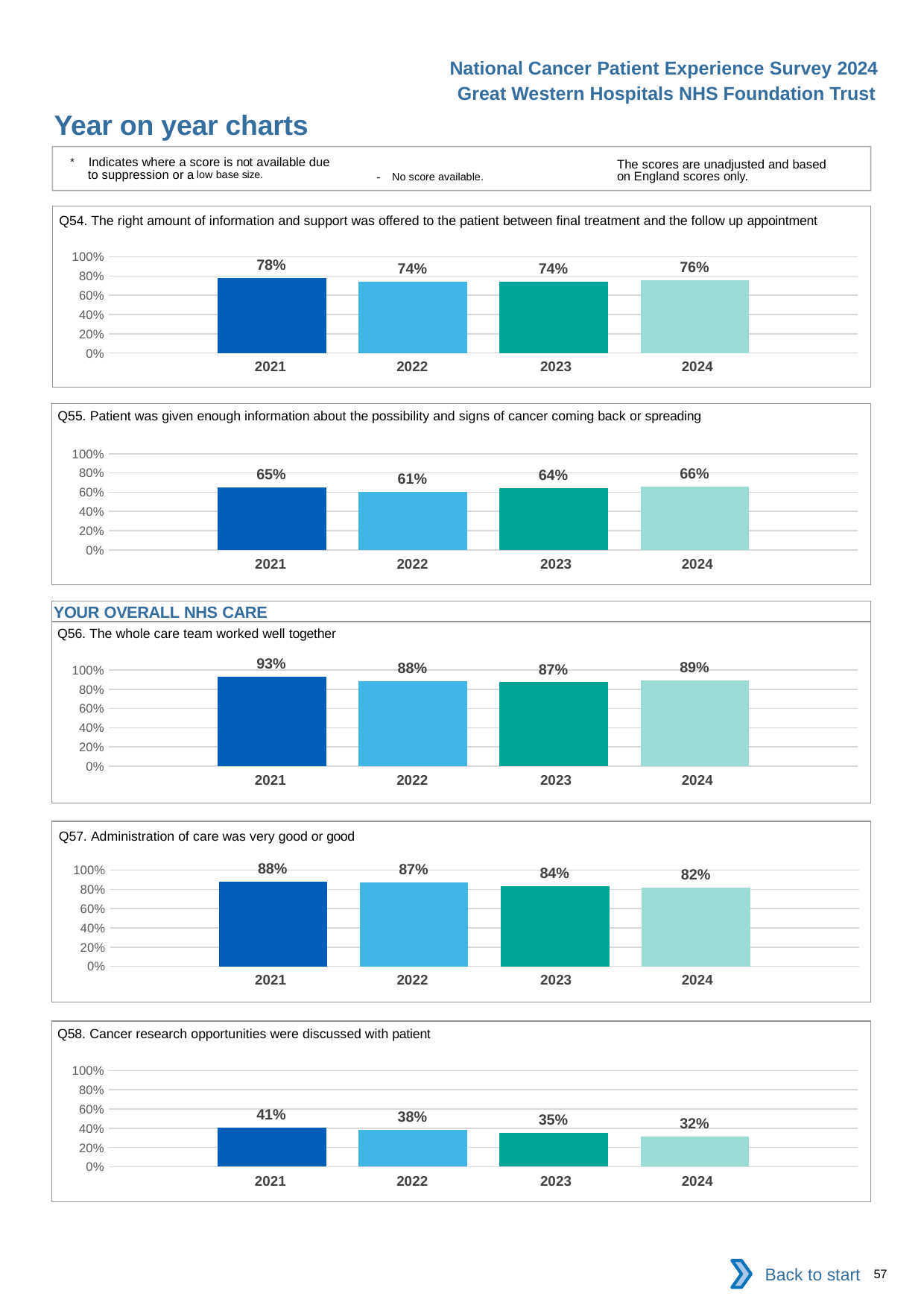
In the Q58 chart, is the value for 2021 greater or less than 60%? less In the Q54 chart, what is the value for 2021? 78% How many years are shown in the Q54 chart? 4 In the Q55 chart, what is the value for 2024? 66% In the Q57 chart, what is the difference between the 2022 and 2023 values? 3% In the Q55 chart, which year has the lowest value? 2022 In the Q56 chart, which year has the highest value? 2021 In the Q58 chart, do the values rise or fall from 2021 to 2024? fall What kind of chart is the Q56 chart? bar chart In the Q56 chart, what is the difference between the 2021 and 2023 values? 6% In the Q58 chart, what is the value for 2024? 32% In the Q57 chart, is the value for 2021 or 2024 larger? 2021